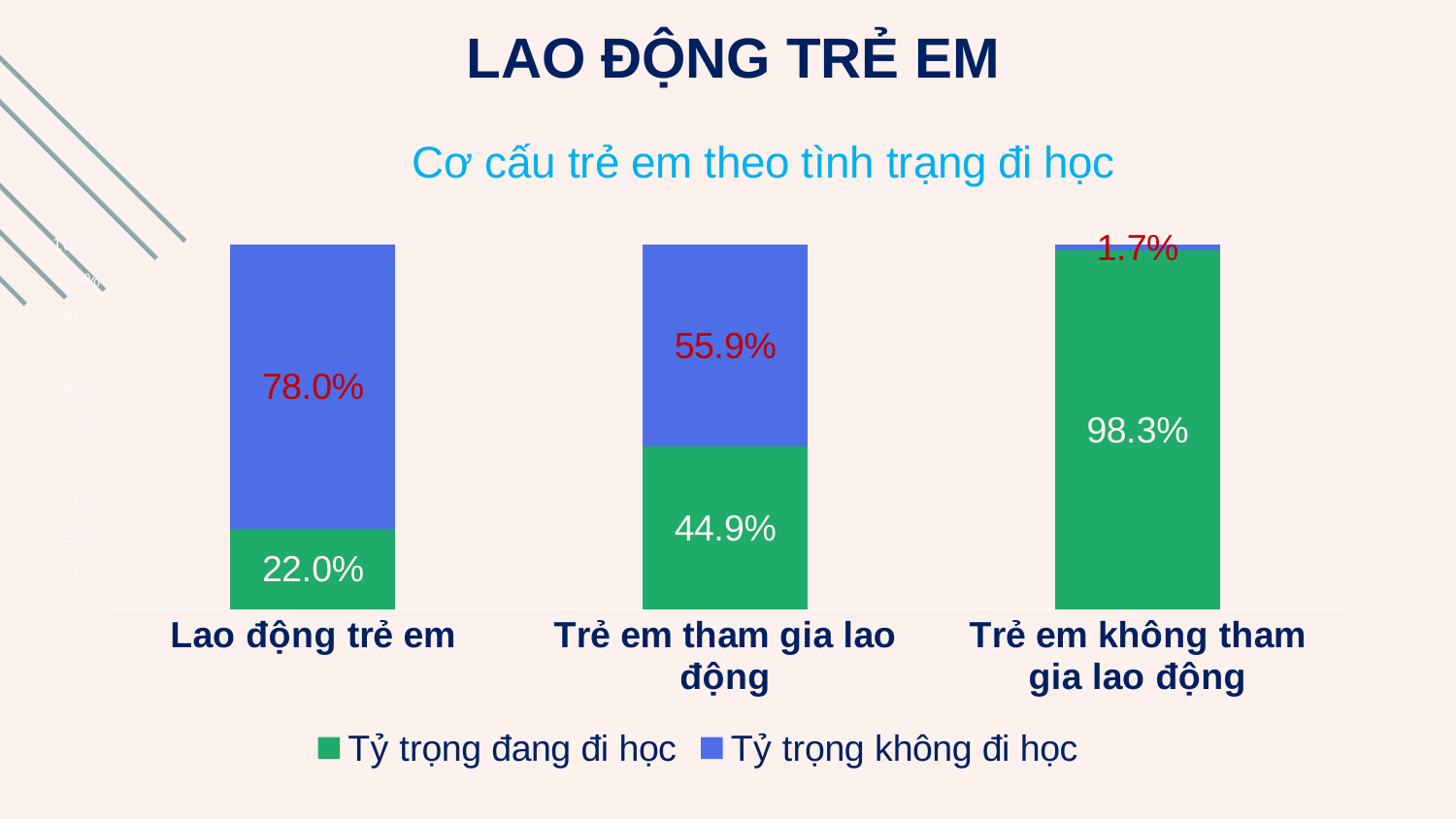
What is the value of "Tỷ trọng không đi học" for "Trẻ em không tham gia lao động"? 1.7% What is the value of "Tỷ trọng đang đi học" for "Lao động trẻ em"? 22.0% What is the difference between "Tỷ trọng không đi học" and "Tỷ trọng đang đi học" for "Lao động trẻ em"? 56.0% What is the value of "Tỷ trọng không đi học" for "Trẻ em tham gia lao động"? 55.9% Which category has the highest value for "Tỷ trọng đang đi học"? Trẻ em không tham gia lao động Which category has the lowest value for "Tỷ trọng không đi học"? Trẻ em không tham gia lao động How many series does the legend list? 2 What is the title of the chart? Cơ cấu trẻ em theo tình trạng đi học What is the value of "Tỷ trọng đang đi học" for "Trẻ em không tham gia lao động"? 98.3% How many categories are shown on the x axis? 3 What kind of chart is shown on the slide? Stacked bar chart For "Trẻ em tham gia lao động", which is larger: "Tỷ trọng đang đi học" or "Tỷ trọng không đi học"? Tỷ trọng không đi học